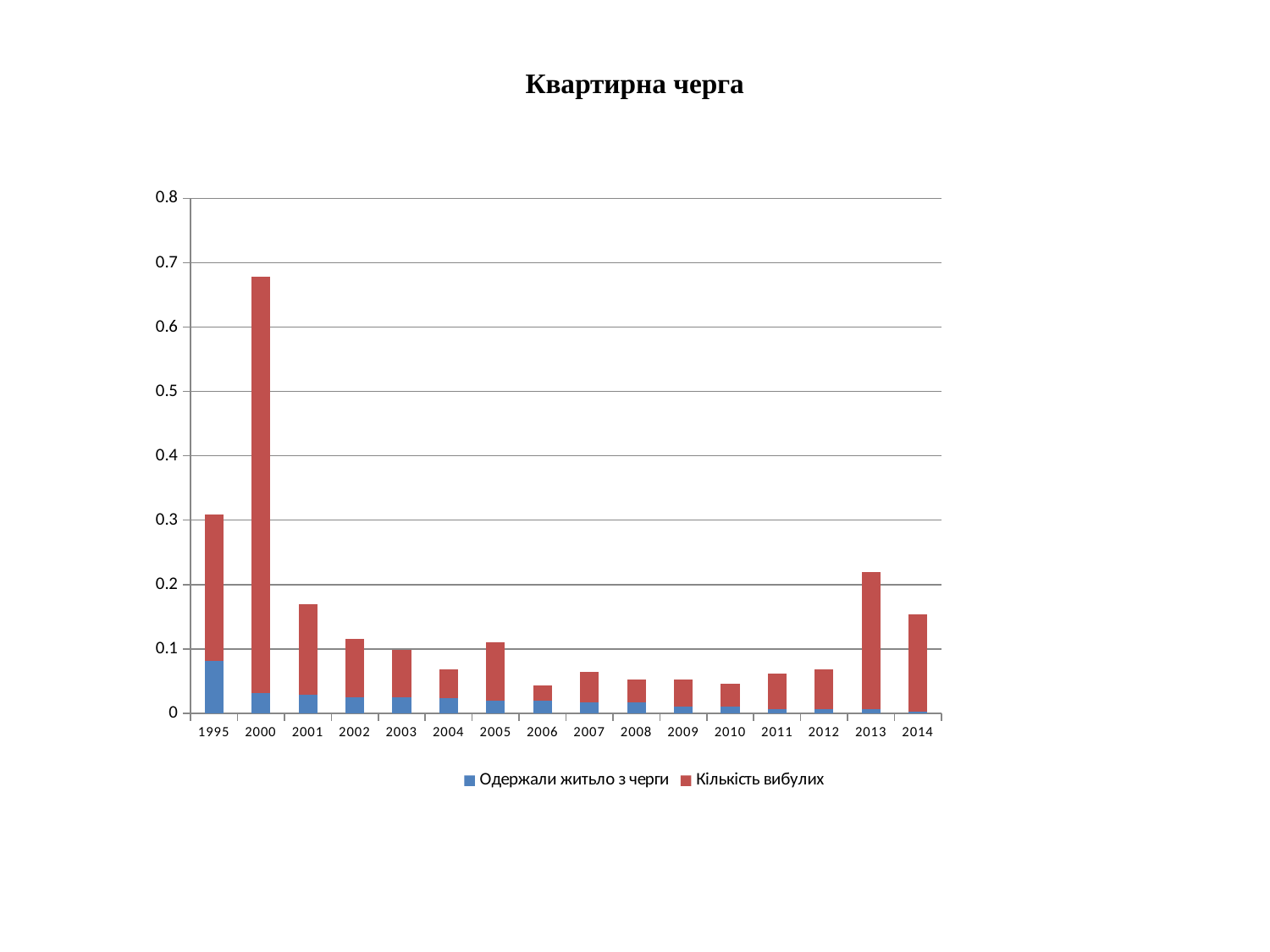
Which year has the larger total bar, 1995 or 2013? 1995 Is the total bar for 1995 greater or less than 0.2? greater Is the total bar for 2006 greater or less than 0.1? less Which year has the smallest value for Одержали житло з черги? 2014 How many years are shown on the x axis? 16 Is the total bar for 2000 greater or less than 0.6? greater What kind of chart is shown on the slide? stacked bar chart What is the title of the chart? Квартирна черга Which year has the tallest bar? 2000 Which series is shown in red? Кількість вибулих How many series does the legend list? 2